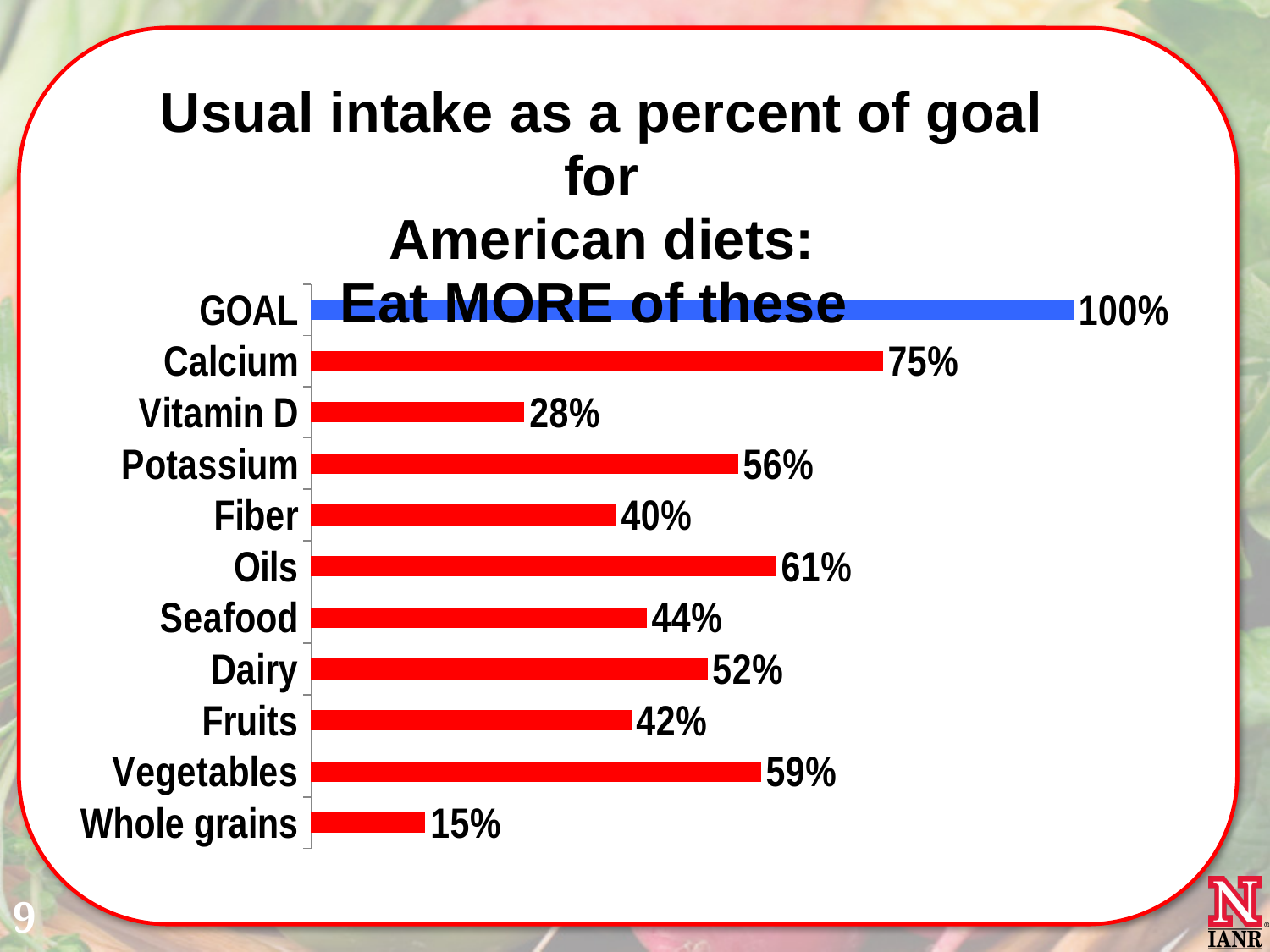
What is the value for Vitamin D? 28% What is the value for Calcium? 75% What is the difference between the values for Oils and Fiber? 21% Which category has the lowest value? Whole grains Which is larger, the value for Potassium or the value for Seafood? Potassium What colour is the GOAL bar? Blue What is the value for Vegetables? 59% What is the difference between the GOAL value and the value for Dairy? 48% How many categories are shown on the chart, including GOAL? 11 Excluding the GOAL bar, which category has the highest value? Calcium What kind of chart is shown on the slide? Bar chart What is the value for Whole grains? 15%